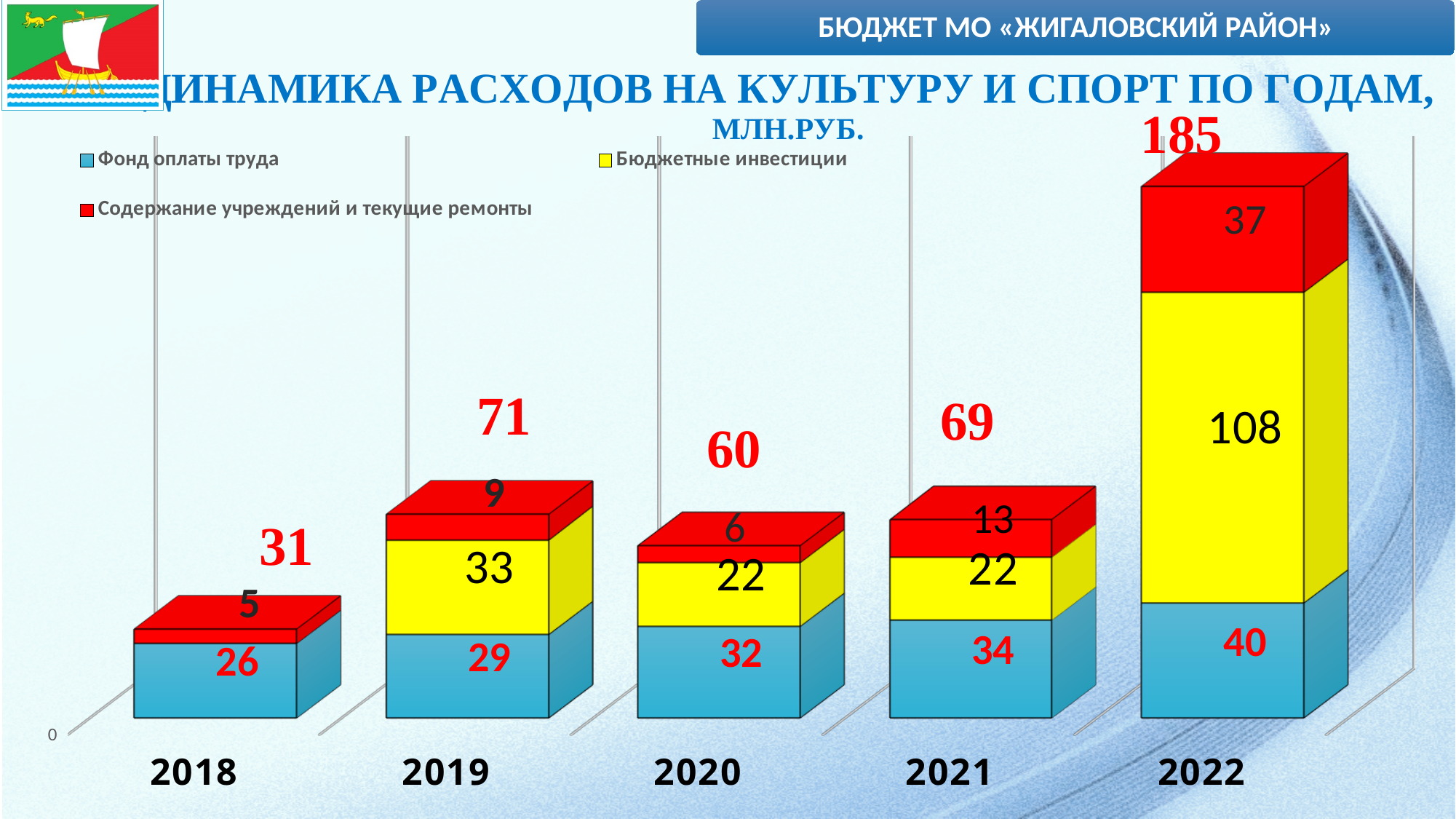
What is the value of Содержание учреждений и текущие ремонты for 2021? 13 What kind of chart is shown on the slide? Stacked bar chart What is the difference between the Фонд оплаты труда values for 2022 and 2018? 14 What is the value of Бюджетные инвестиции for 2019? 33 Which year has the highest total expenditure? 2022 How many series does the legend list? 3 What is the total shown above the stacked bar for 2020? 60 Which colour represents Бюджетные инвестиции in the chart? Yellow Which year has the lowest total expenditure? 2018 How many years are shown on the x axis? 5 Which is larger: the total for 2019 or the total for 2021? 2019 What is the value of Фонд оплаты труда for 2022? 40